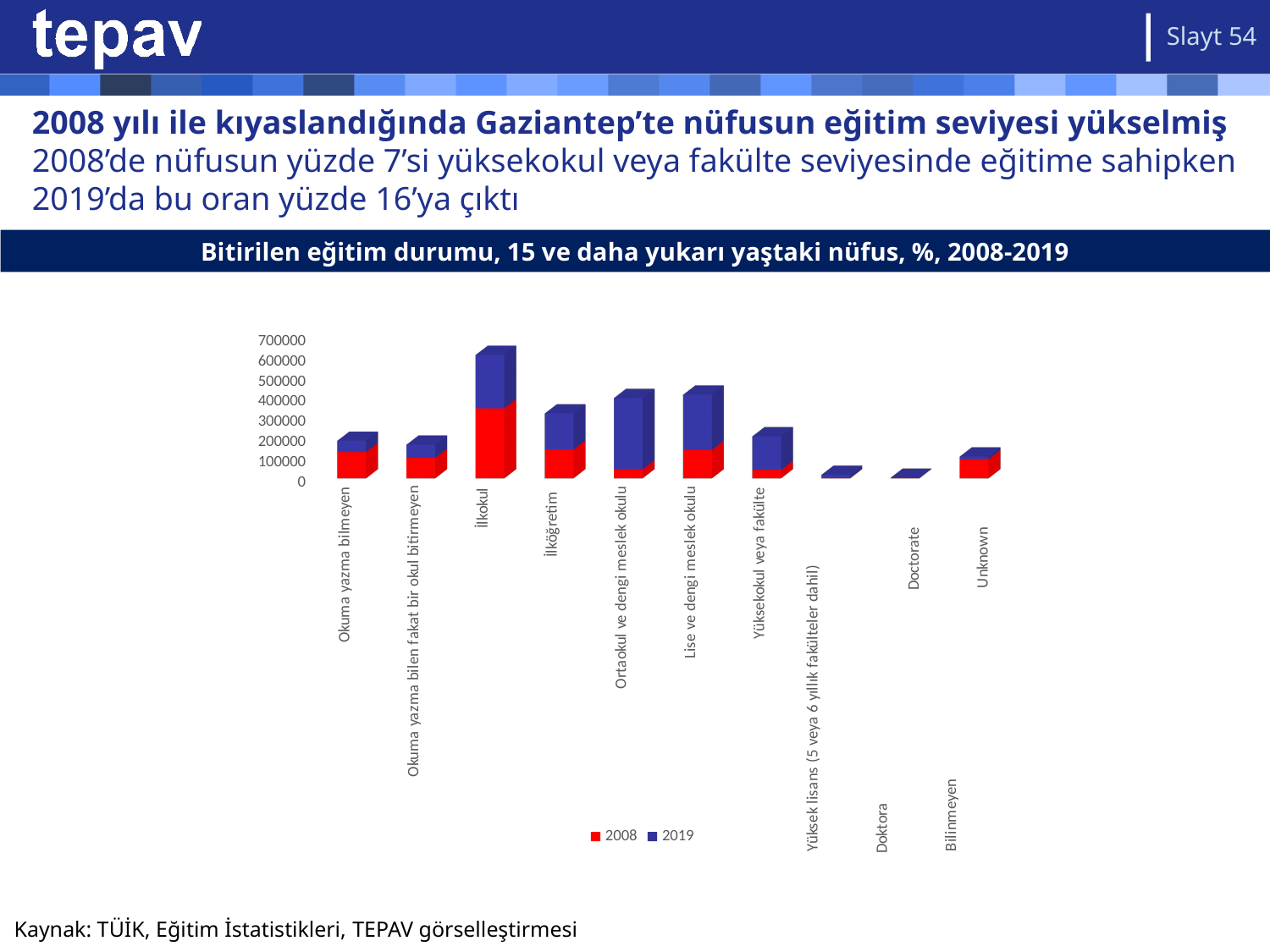
Is the total stacked value for Doktora greater or less than 100000? less Is the total stacked value for İlkokul greater or less than 500000? greater Is the total stacked value for Lise ve dengi meslek okulu greater or less than 300000? greater How many series does the legend list? 2 How many education categories (bars) are plotted on the chart? 10 Which has the larger total stacked bar, Ortaokul ve dengi meslek okulu or Okuma yazma bilmeyen? Ortaokul ve dengi meslek okulu What colour represents the 2008 series? red Which series are listed in the legend? 2008 and 2019 Which category has the highest total stacked bar? İlkokul Which has the larger total stacked bar, İlkokul or Lise ve dengi meslek okulu? İlkokul What kind of chart is shown on the slide? bar chart